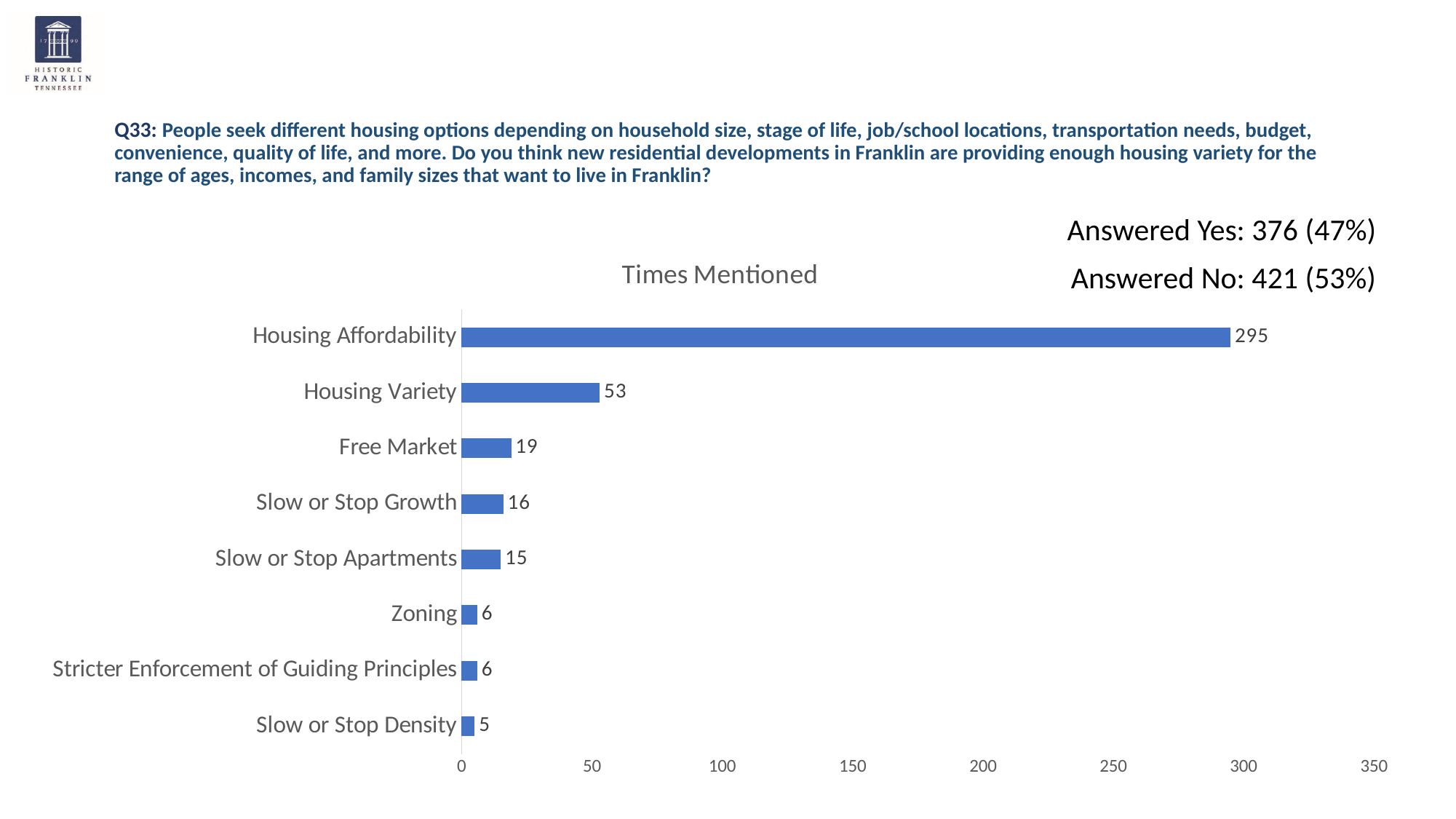
How many times was Housing Affordability mentioned? 295 Is the value for Housing Variety greater or less than 100? less What is the value for Housing Variety? 53 What is the title of the chart? Times Mentioned What kind of chart is shown on the slide? bar chart Which category has the lowest number of times mentioned? Slow or Stop Density What is the value for Slow or Stop Apartments? 15 How many categories are shown in the chart? 8 What is the difference between the values for Housing Affordability and Housing Variety? 242 Which is larger, the value for Free Market or the value for Slow or Stop Apartments? Free Market What is the difference between the values for Free Market and Slow or Stop Growth? 3 Which category has the highest number of times mentioned? Housing Affordability